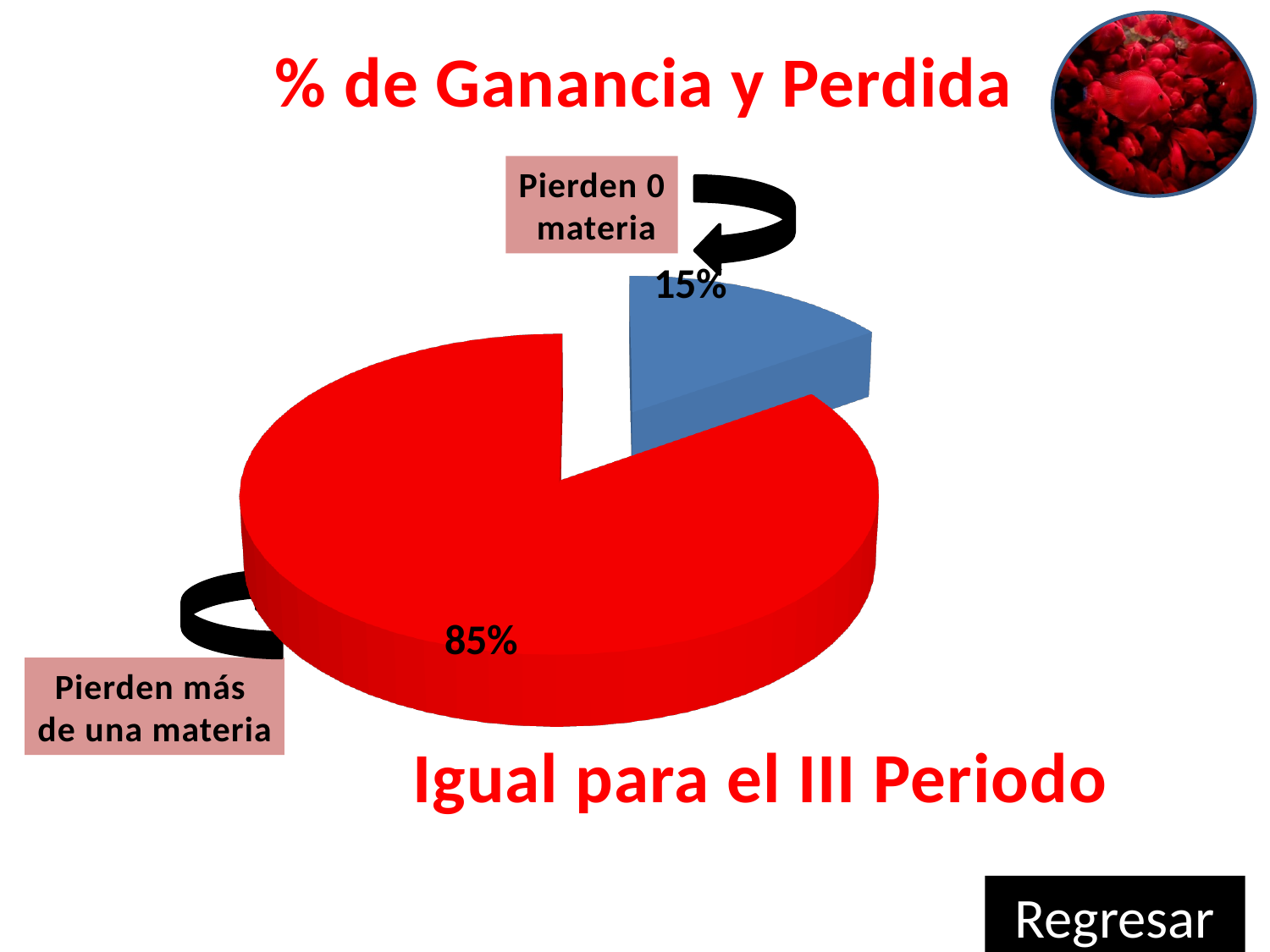
What is the title of the chart? % de Ganancia y Perdida Which slice of the pie is the largest? Pierden más de una materia What share of the pie does the "Pierden 0 materia" slice represent? 15% How many slices does the pie chart have? 2 Which is larger: the "Pierden 0 materia" slice or the "Pierden más de una materia" slice? Pierden más de una materia What percentage is shown for the slice labelled "Pierden 0 materia"? 15% What percentage is shown for the slice labelled "Pierden más de una materia"? 85% What colour is the "Pierden más de una materia" slice? red What is the difference in percentage points between the "Pierden más de una materia" slice and the "Pierden 0 materia" slice? 70 Which slice of the pie is the smallest? Pierden 0 materia What kind of chart is shown on the slide? pie chart